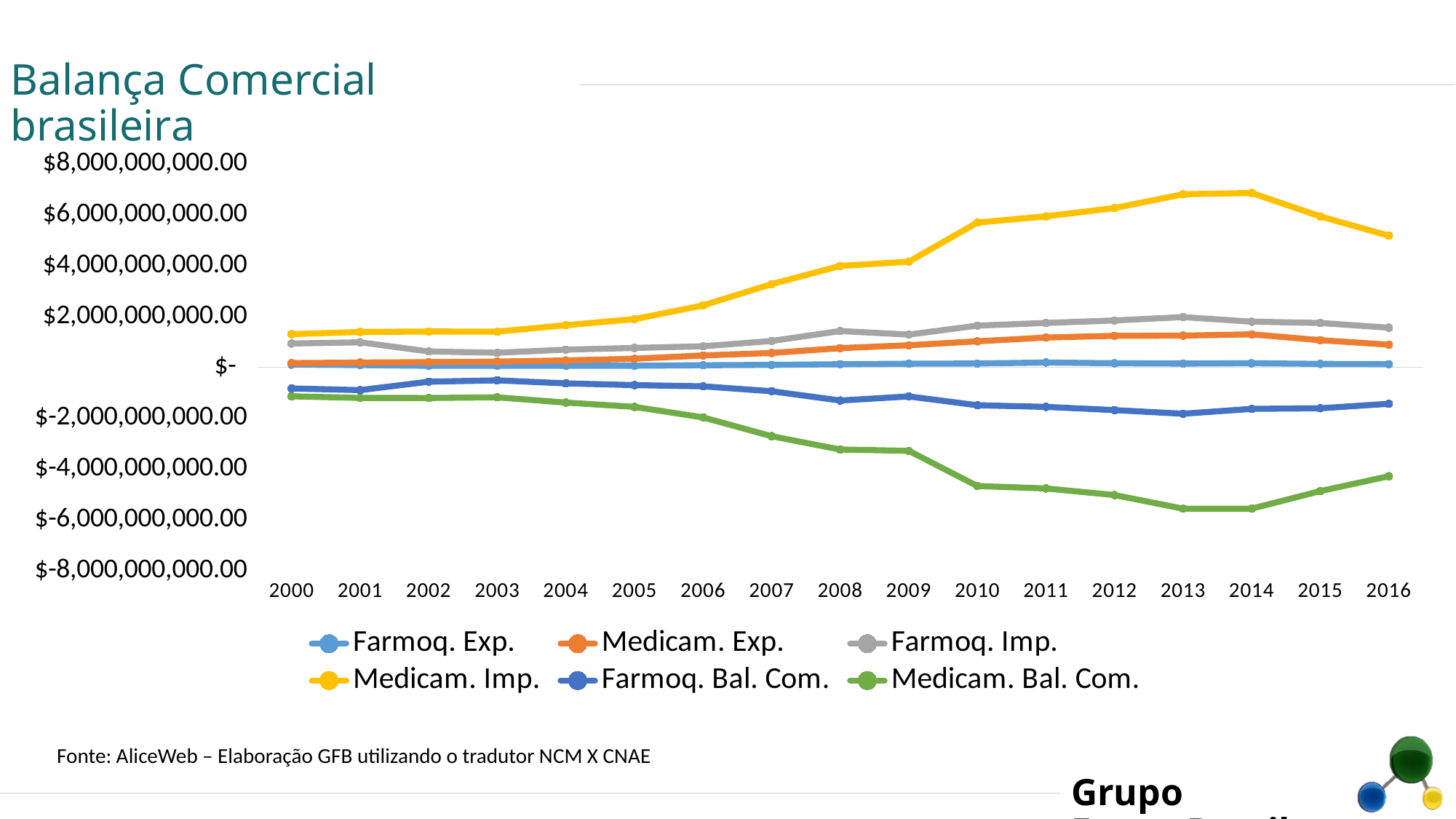
Which series has the lowest value in 2013? Medicam. Bal. Com. What colour is the Medicam. Imp. line? yellow How many years are shown on the x axis? 17 Is the value for Medicam. Bal. Com. in 2010 greater or less than $-4,000,000,000.00? less Is the value for Medicam. Bal. Com. in 2008 greater or less than $-2,000,000,000.00? less What kind of chart is shown on the slide? line chart Is the value for Medicam. Imp. in 2013 greater or less than $6,000,000,000.00? greater What is the title of the chart? Balança Comercial brasileira How many series does the legend list? 6 Which series has the highest value in 2014? Medicam. Imp. In 2000, which is higher: Medicam. Exp. or Farmoq. Imp.? Farmoq. Imp.